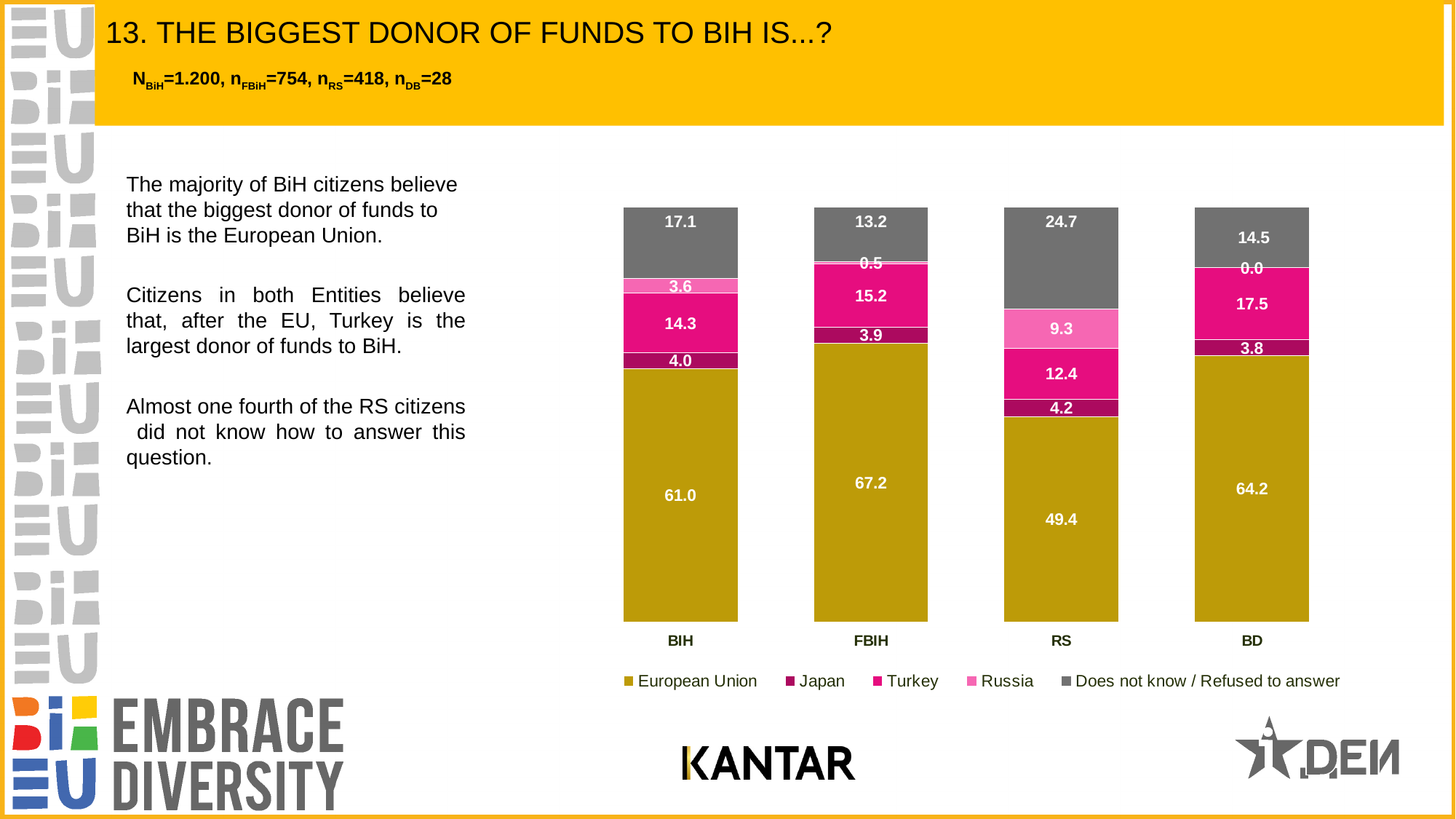
What is the Turkey value for BD? 17.5 What type of chart is shown on the slide? Stacked bar chart What is the Russia value for FBIH? 0.5 What is the difference between the European Union values for FBIH and RS? 17.8 Which category has the lowest Russia value? BD What is the 'Does not know / Refused to answer' value for RS? 24.7 Which category has the highest European Union value? FBIH What is the total of the stacked bar for BIH? 100.0 How many series does the legend list? 5 How many categories are shown on the x axis? 4 What is the European Union value for RS? 49.4 Which is larger, the Turkey value for BIH or the Turkey value for RS? BIH